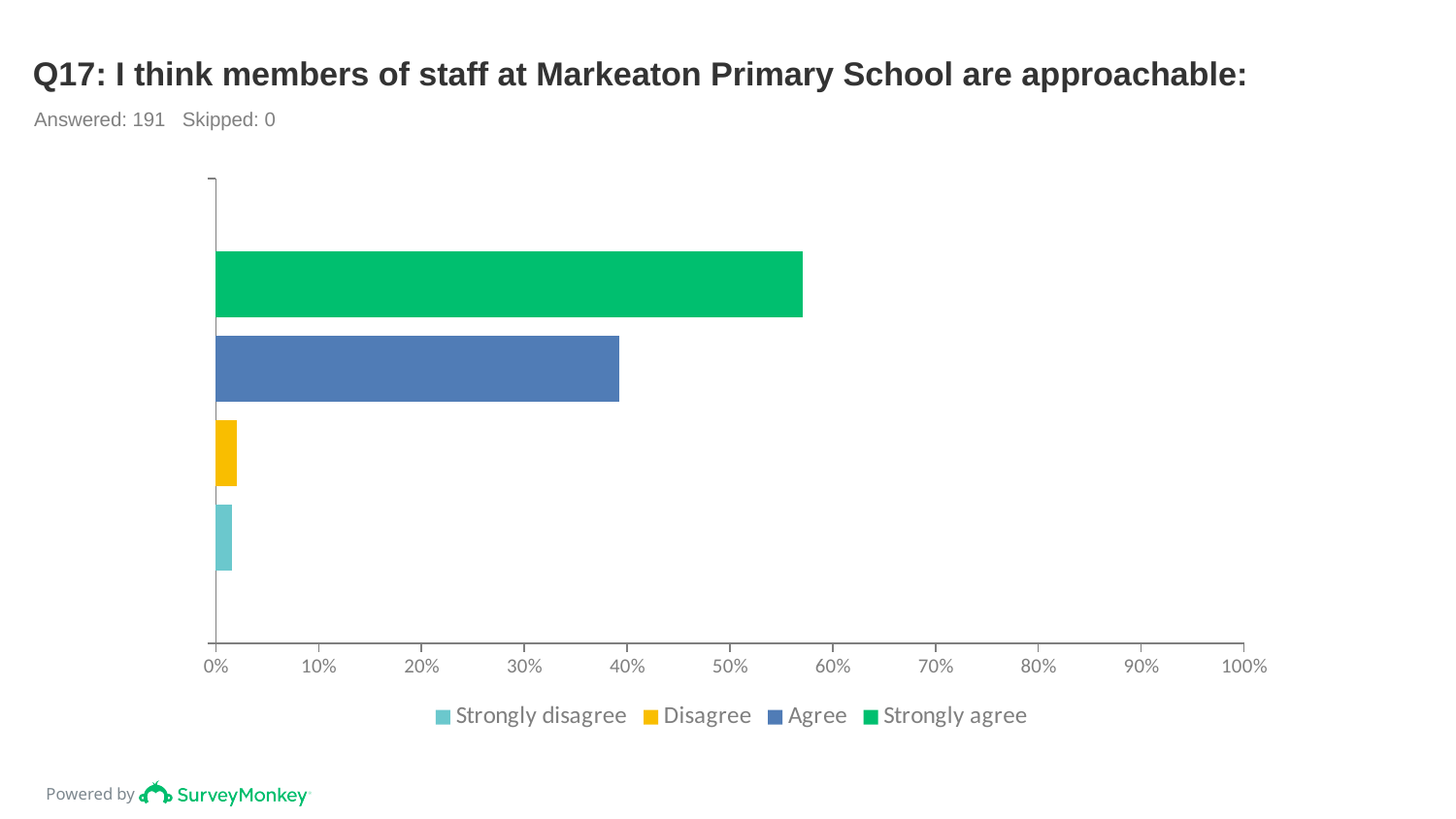
Is the value for Strongly agree greater or less than 60%? less How many series does the legend list? 4 Is the value for Agree greater or less than 30%? greater Which is larger, the value for Agree or the value for Disagree? Agree Is the value for Disagree greater or less than 10%? less Which response option has the highest value? Strongly agree What kind of chart is shown on the slide? bar chart Which is larger, the value for Strongly agree or the value for Agree? Strongly agree How many respondents answered this question according to the slide? 191 How many bars are plotted in the chart? 4